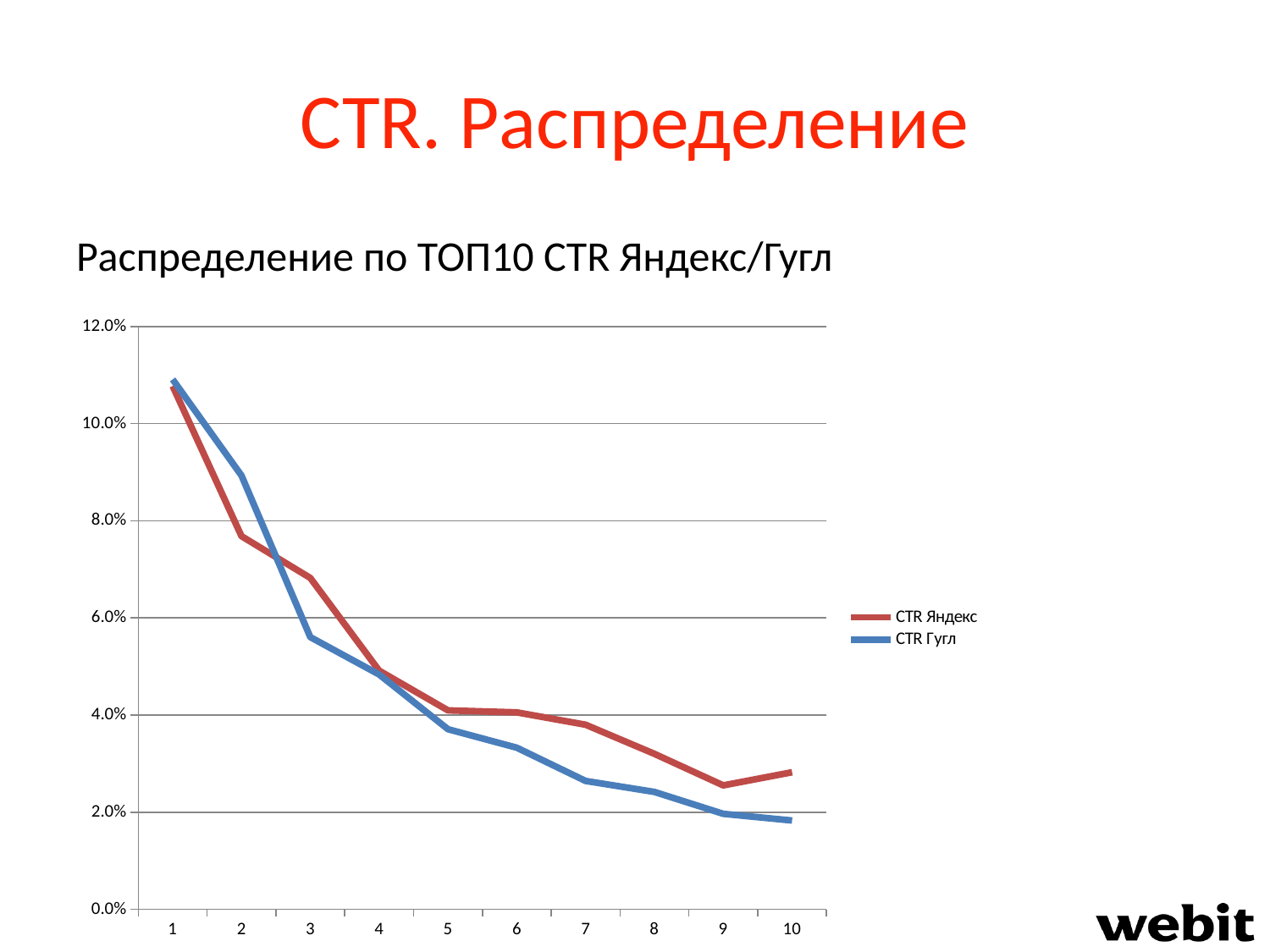
Is the CTR Яндекс value at position 2 greater or less than 8.0%? less At which position is the CTR Гугл value lowest? 10 Do the CTR Яндекс values rise or fall from position 1 to position 9? fall What is the title of the chart? Распределение по ТОП10 CTR Яндекс/Гугл How many series does the legend list? 2 At position 3, which series has the higher value, CTR Яндекс or CTR Гугл? CTR Яндекс At position 2, which series has the higher value, CTR Яндекс or CTR Гугл? CTR Гугл At which position is the CTR Яндекс value highest? 1 How many positions are shown along the x axis? 10 Is the CTR Гугл value at position 10 greater or less than 2.0%? less Is the CTR Гугл value at position 2 greater or less than 8.0%? greater What kind of chart is shown on the slide? line chart